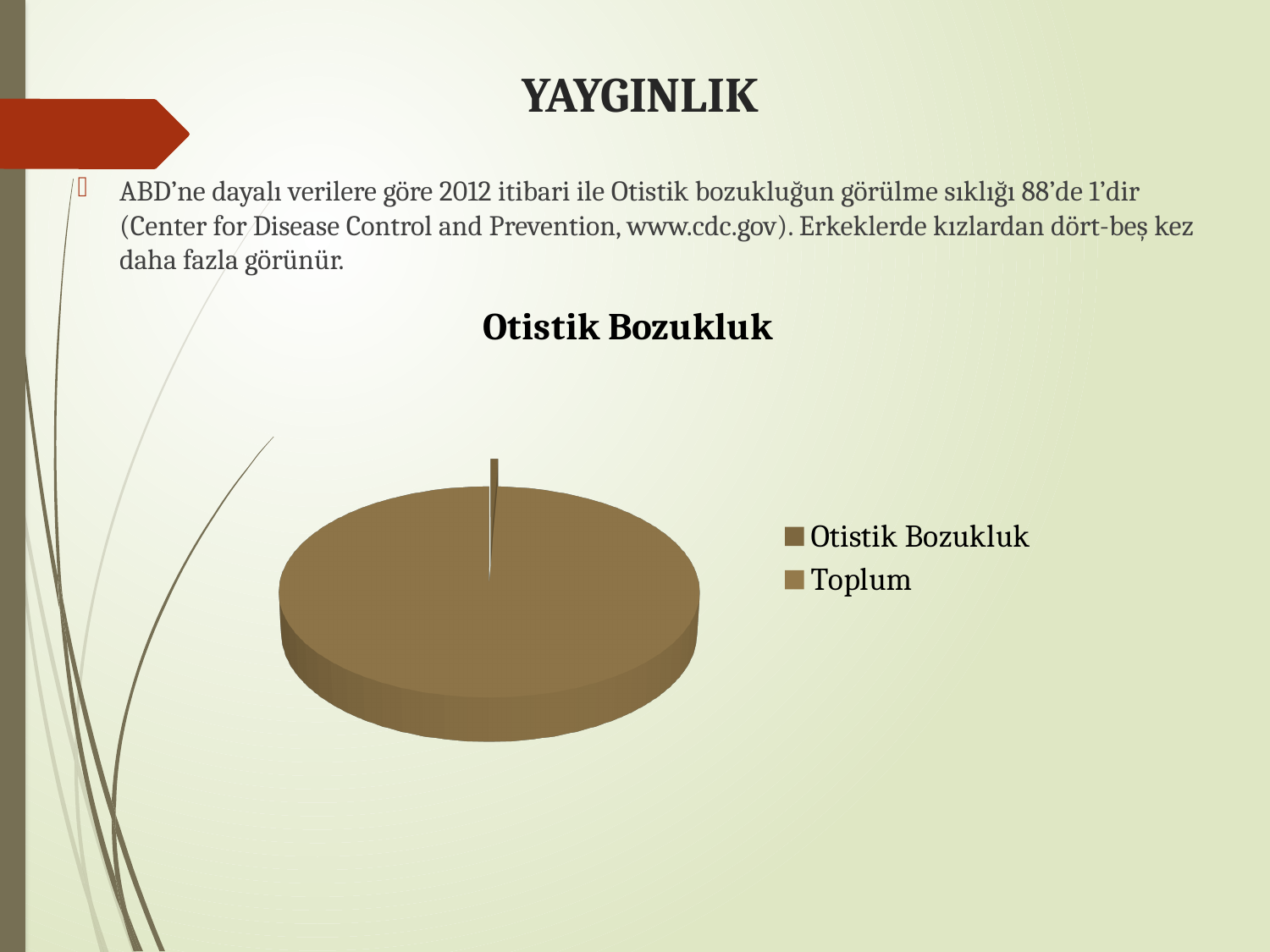
What is the title of the chart? Otistik Bozukluk How many slices does the pie chart have? 2 What are the two categories listed in the chart legend? Otistik Bozukluk and Toplum Which category has the smallest slice of the pie? Otistik Bozukluk Which category has the largest slice of the pie? Toplum What kind of chart is shown on the slide? pie chart How many entries does the chart legend list? 2 Which slice is larger, Otistik Bozukluk or Toplum? Toplum